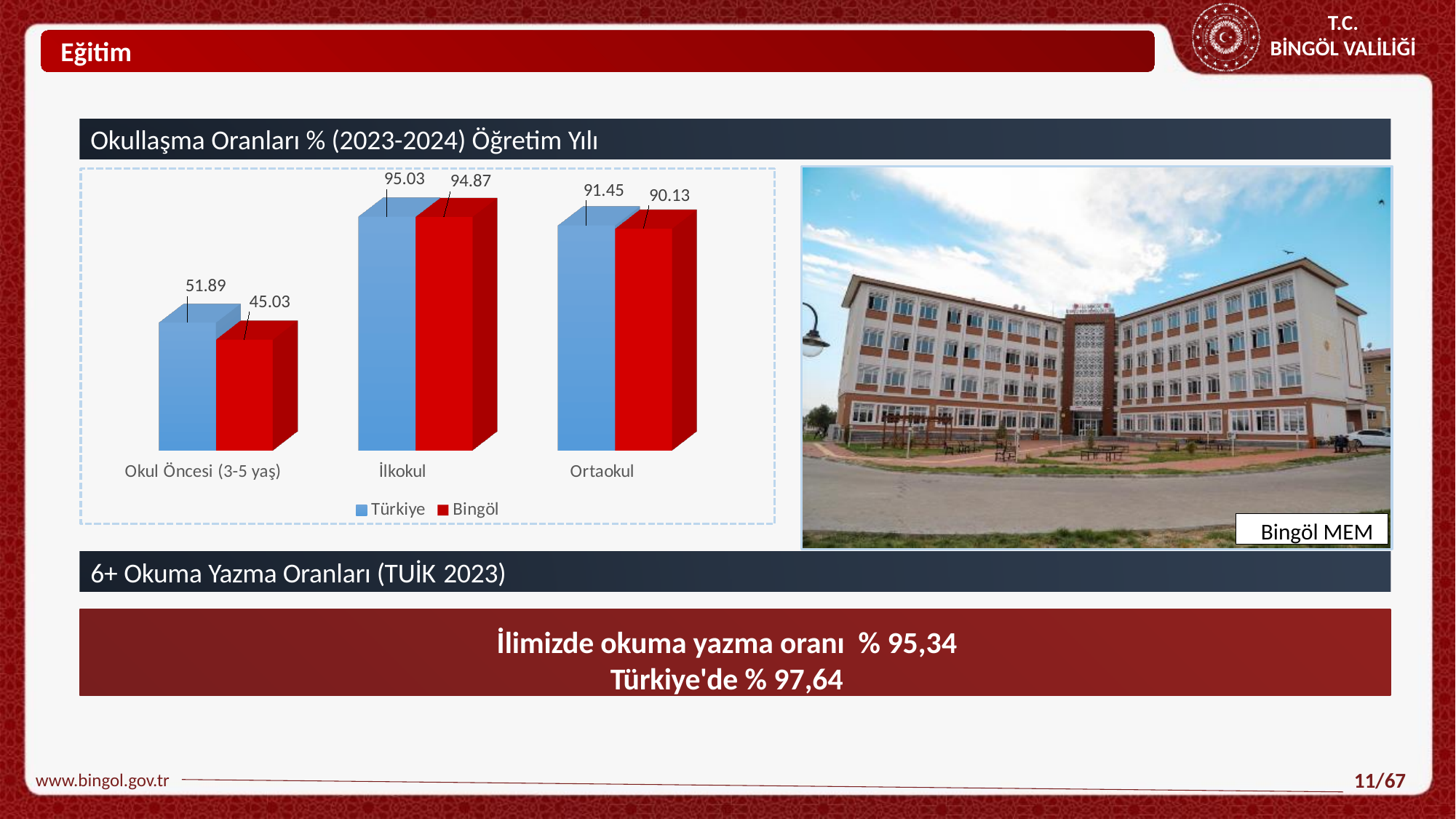
Which category has the highest Türkiye value? İlkokul For Okul Öncesi (3-5 yaş), which is larger: the Türkiye value or the Bingöl value? Türkiye What is the difference between the Türkiye and Bingöl values for Okul Öncesi (3-5 yaş)? 6.86 What type of chart is shown on the slide? Bar chart How many categories are shown on the x axis of the chart? 3 What is the Bingöl value for İlkokul? 94.87 What is the difference between the Türkiye and Bingöl values for Ortaokul? 1.32 What is the Türkiye value for Ortaokul? 91.45 Which category has the lowest Bingöl value? Okul Öncesi (3-5 yaş) What is the Türkiye value for Okul Öncesi (3-5 yaş)? 51.89 What is the Bingöl value for Okul Öncesi (3-5 yaş)? 45.03 How many series does the chart legend list? 2